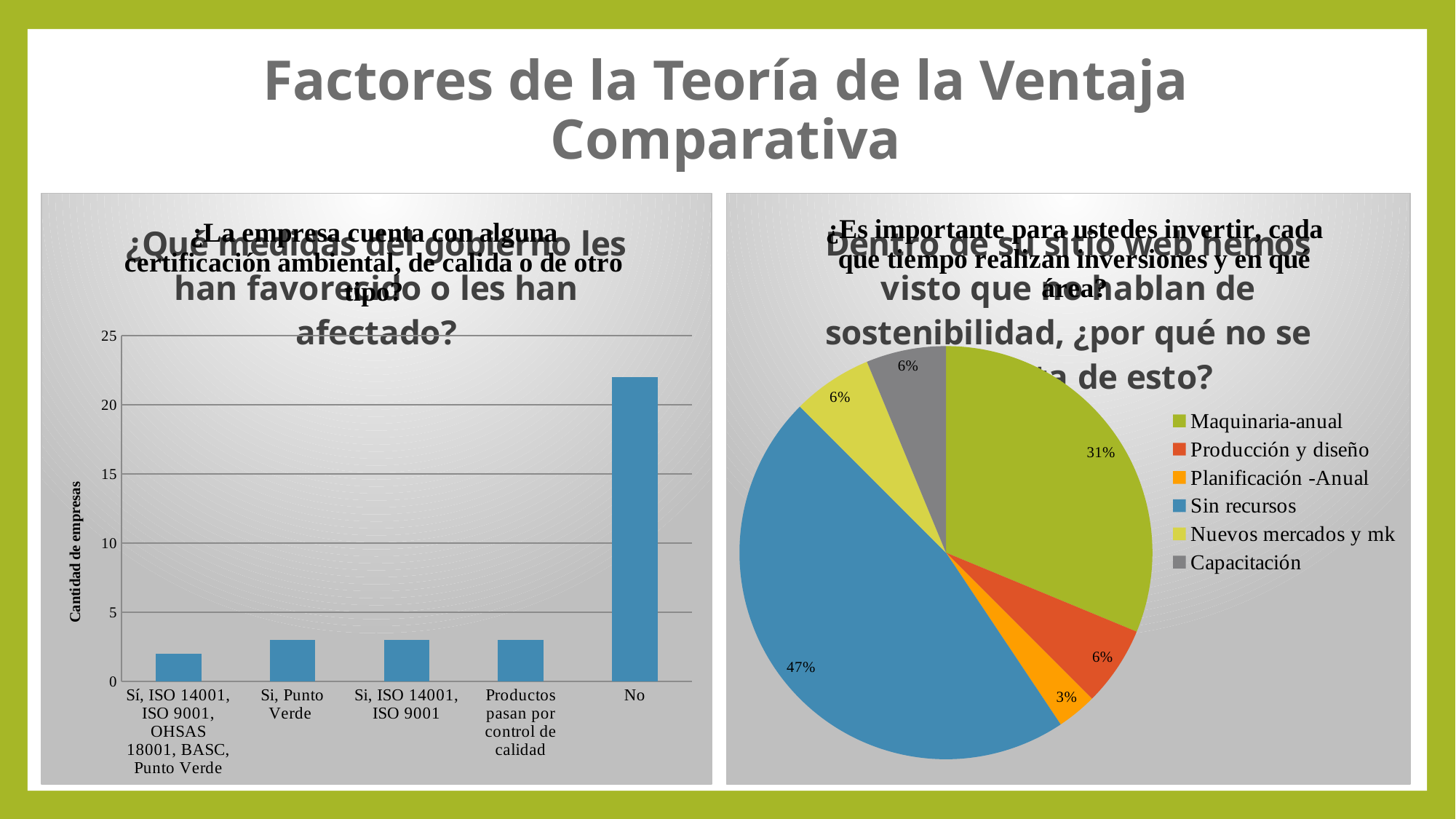
In the pie chart on the right, what share does "Sin recursos" have? 47% In the pie chart on the right, how many categories does the legend list? 6 In the bar chart on the left, how many categories are shown on the x axis? 5 In the pie chart on the right, what share does "Maquinaria-anual" have? 31% What kind of chart is the chart on the left of the slide? bar chart In the bar chart on the left, which category has the highest value? No What kind of chart is the chart on the right of the slide? pie chart In the pie chart on the right, which category has the smallest share? Planificación -Anual In the bar chart on the left, what is the label of the vertical axis? Cantidad de empresas In the bar chart on the left, is the value for "Si, Punto Verde" greater or less than 5? less In the bar chart on the left, is the value for "No" greater or less than 20? greater In the pie chart on the right, what is the difference between the shares of "Sin recursos" and "Maquinaria-anual"? 16%